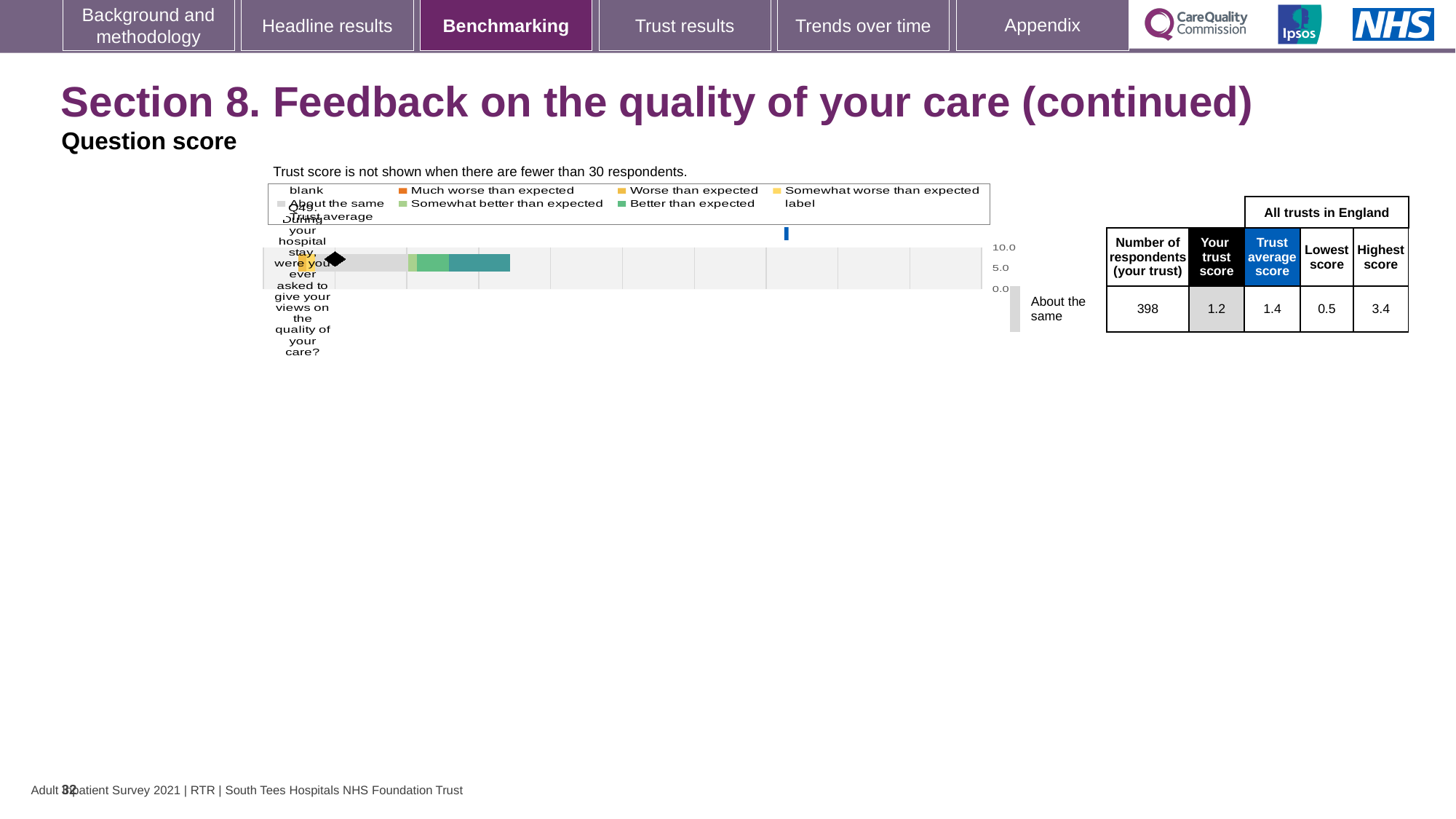
What is the lowest score across all trusts in England for Q49? 0.5 Which colour in the legend represents 'Much worse than expected'? orange What is the trust score for Q49 (During your hospital stay, were you ever asked to give your views on the quality of your care?)? 1.2 Which is larger for Q49, the trust score or the trust average score? trust average score What is the difference between the highest and lowest scores for Q49 across all trusts in England? 2.9 Is the trust score for Q49 greater or less than 5.0 on the chart axis? less How many questions are plotted in the benchmarking chart? 1 Which benchmark category is the trust's result for Q49 placed in? About the same What kind of chart is used to show the benchmarking result for Q49? bar chart What is the highest score across all trusts in England for Q49? 3.4 How many respondents from the trust answered Q49? 398 What is the trust average score for Q49? 1.4